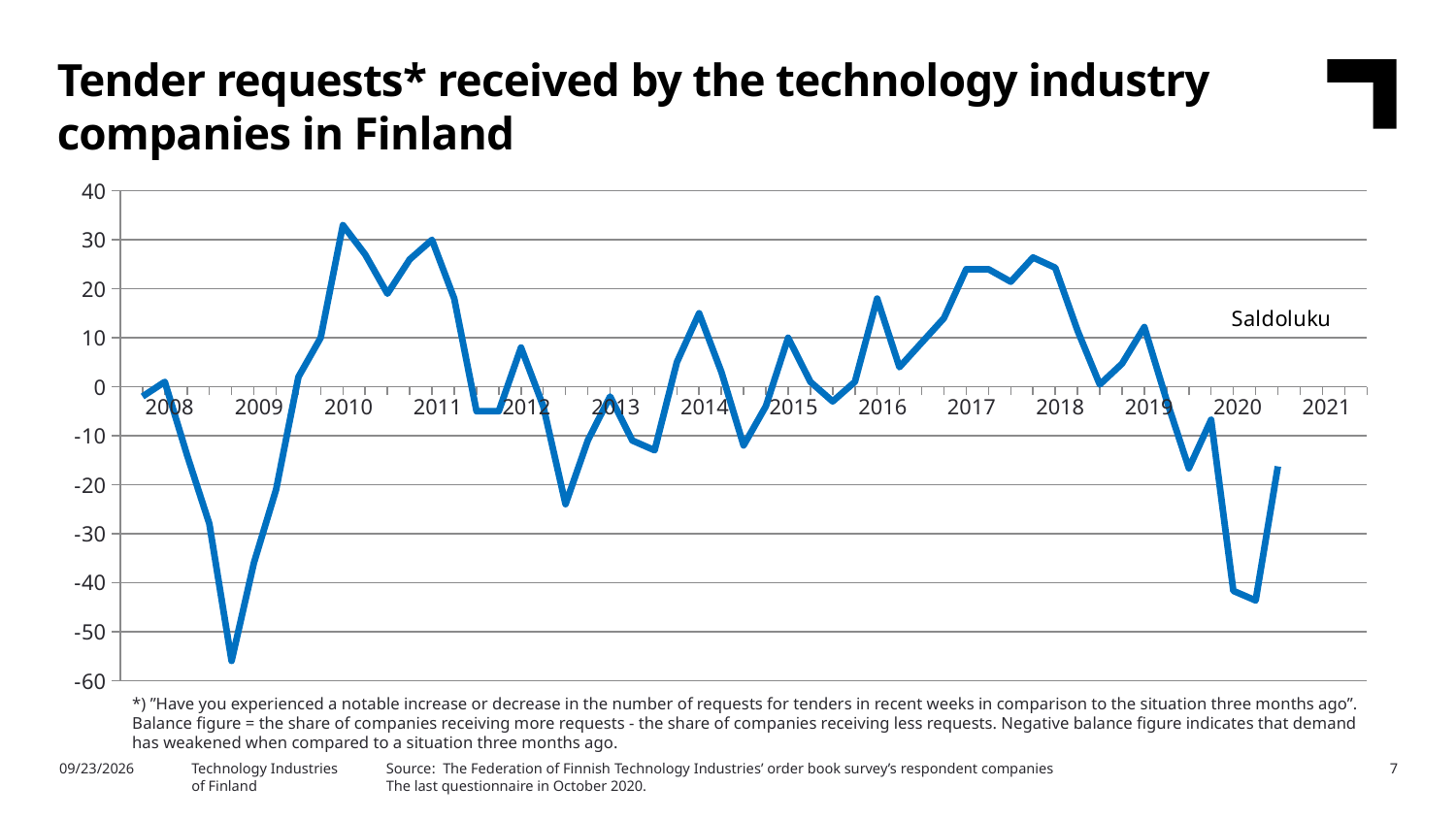
In which year does the line reach its lowest point? 2009 What is the name of the series shown in the chart? Saldoluku What kind of chart is shown on the slide? line chart Is the peak value of the line in 2017 greater or less than 20? greater Is the lowest value of the line in 2009 greater or less than -50? less Is the peak value of the line in 2010 greater or less than 30? greater How many series does the chart show? 1 What is the title of the chart on the slide? Tender requests* received by the technology industry companies in Finland Which is lower, the trough of the line in 2009 or the trough in 2020? 2009 Do the values rise or fall from the start of 2008 to the low point in 2009? fall